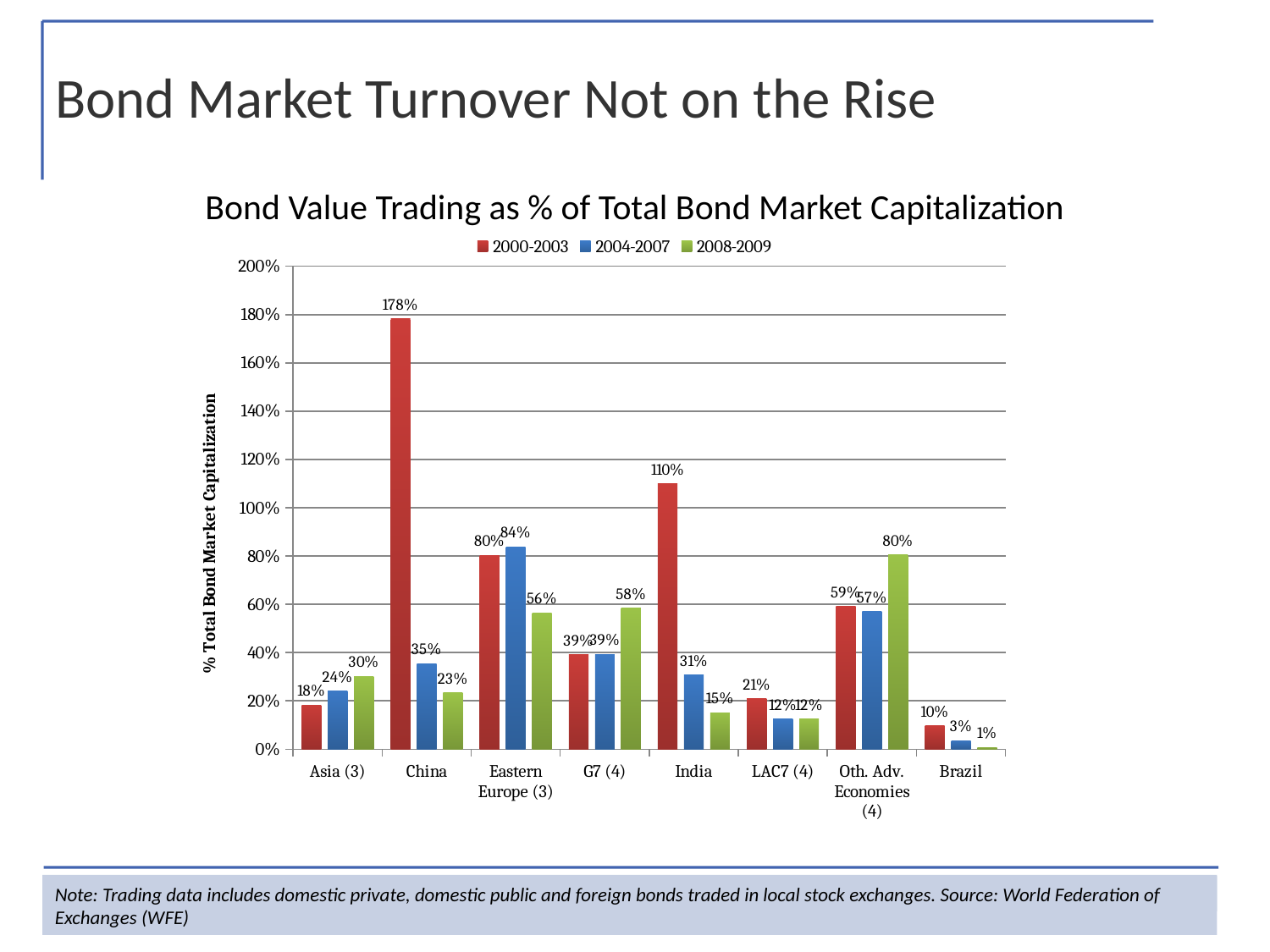
How many categories are shown on the x axis? 8 What is the value for China in the 2000-2003 series? 178% What is the title of the chart? Bond Value Trading as % of Total Bond Market Capitalization What is the value for Oth. Adv. Economies (4) in the 2008-2009 series? 80% Do the values for Brazil rise or fall from the 2000-2003 series to the 2008-2009 series? Fall What is the difference between the 2000-2003 and 2008-2009 values for India? 95% Which category has the highest value in the 2000-2003 series? China Which category has the lowest value in the 2008-2009 series? Brazil What is the value for India in the 2004-2007 series? 31% What kind of chart is shown on the slide? Bar chart Which is larger for Asia (3): the 2004-2007 value or the 2008-2009 value? 2008-2009 How many series does the legend list? 3